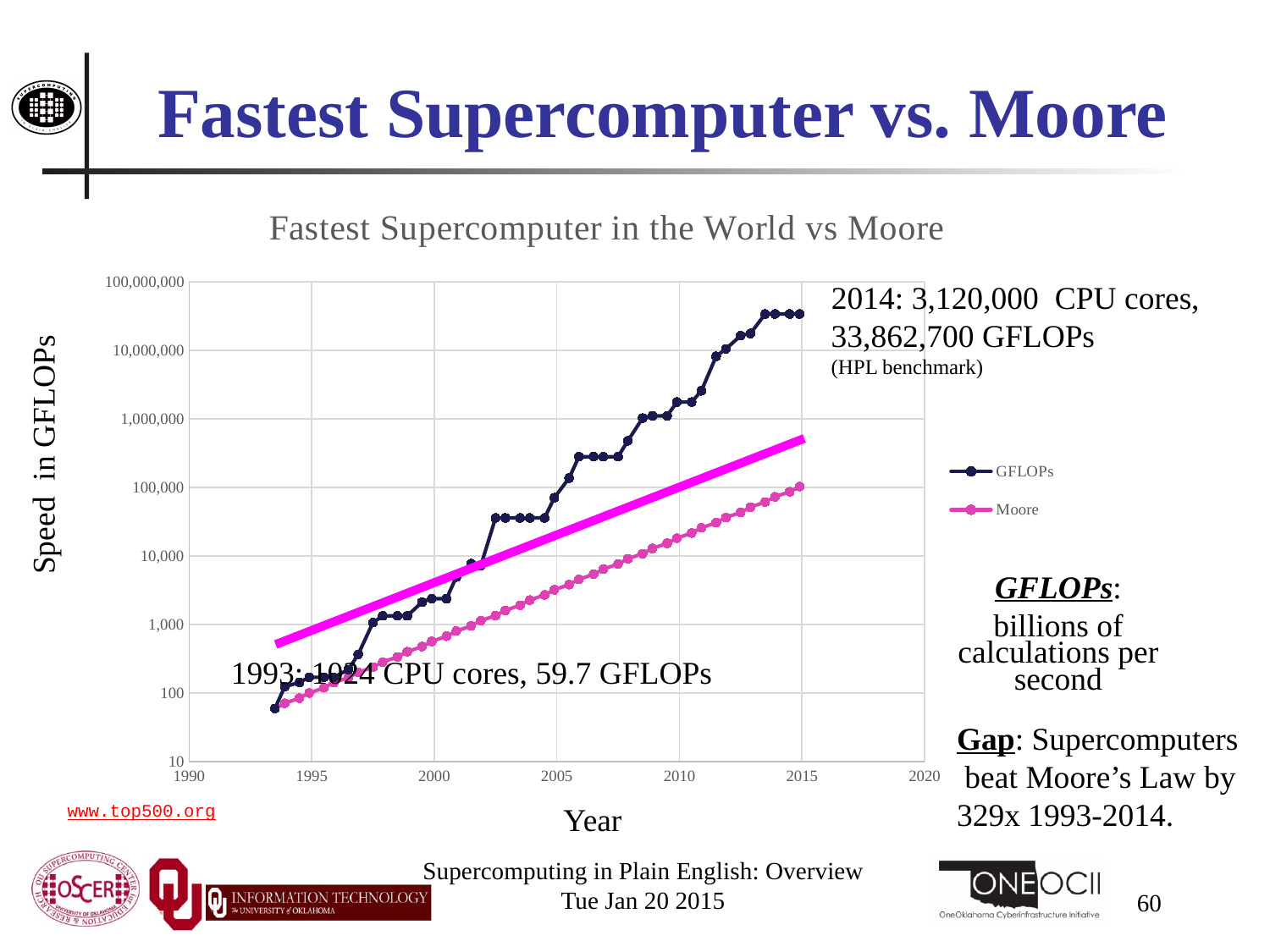
Is the GFLOPs value in 2010 greater or less than 1,000,000? greater What kind of chart is shown on the slide? line chart What is the label on the chart's vertical axis? Speed in GFLOPs According to the slide, what was the speed of the fastest supercomputer in 1993? 59.7 GFLOPs How many series does the chart's legend list? 2 What are the two series named in the chart's legend? GFLOPs and Moore Does the GFLOPs series rise or fall as the year increases? rise In 2014, which series has the higher value, GFLOPs or Moore? GFLOPs By how much did the fastest supercomputer's speed in 2014 exceed its speed in 1993, using the values printed on the slide? 33,862,640.3 GFLOPs According to the slide, what was the speed of the fastest supercomputer in 2014? 33,862,700 GFLOPs Is the Moore value in 2015 greater or less than 1,000,000? less How many CPU cores did the fastest supercomputer have in 2014, according to the slide? 3,120,000